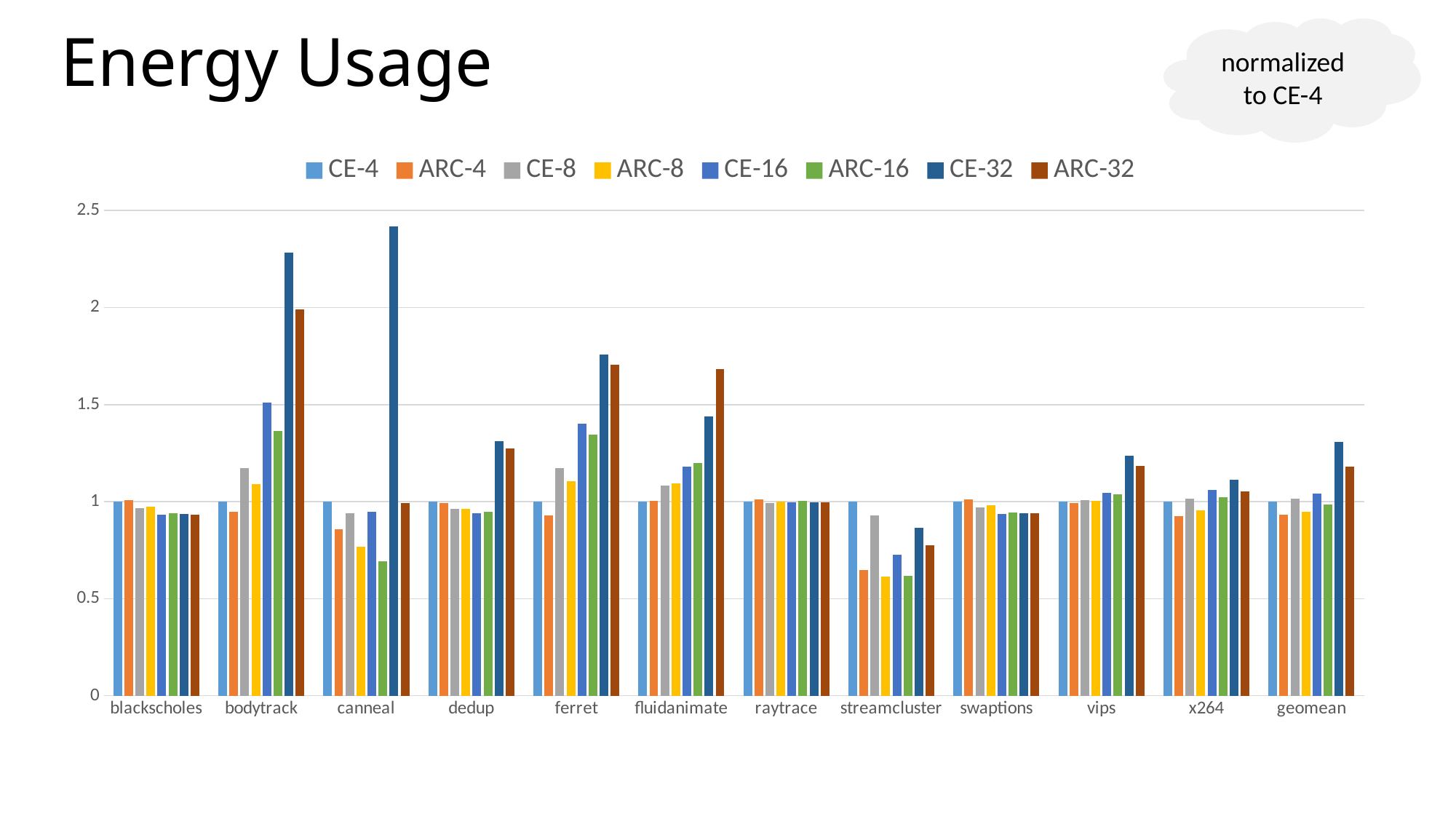
Is the value of CE-32 for geomean greater or less than 1? greater Is the value of ARC-16 for canneal greater or less than 1? less Which series has the highest value for canneal? CE-32 Is the value of CE-32 for canneal greater or less than 2? greater How many benchmark categories are shown along the x axis? 12 What kind of chart is shown on the slide? bar chart For fluidanimate, which is larger: CE-32 or ARC-32? ARC-32 What is the title of the chart? Energy Usage Which category has the tallest bar in the chart? canneal Which series has the highest value for bodytrack? CE-32 How many series does the legend list? 8